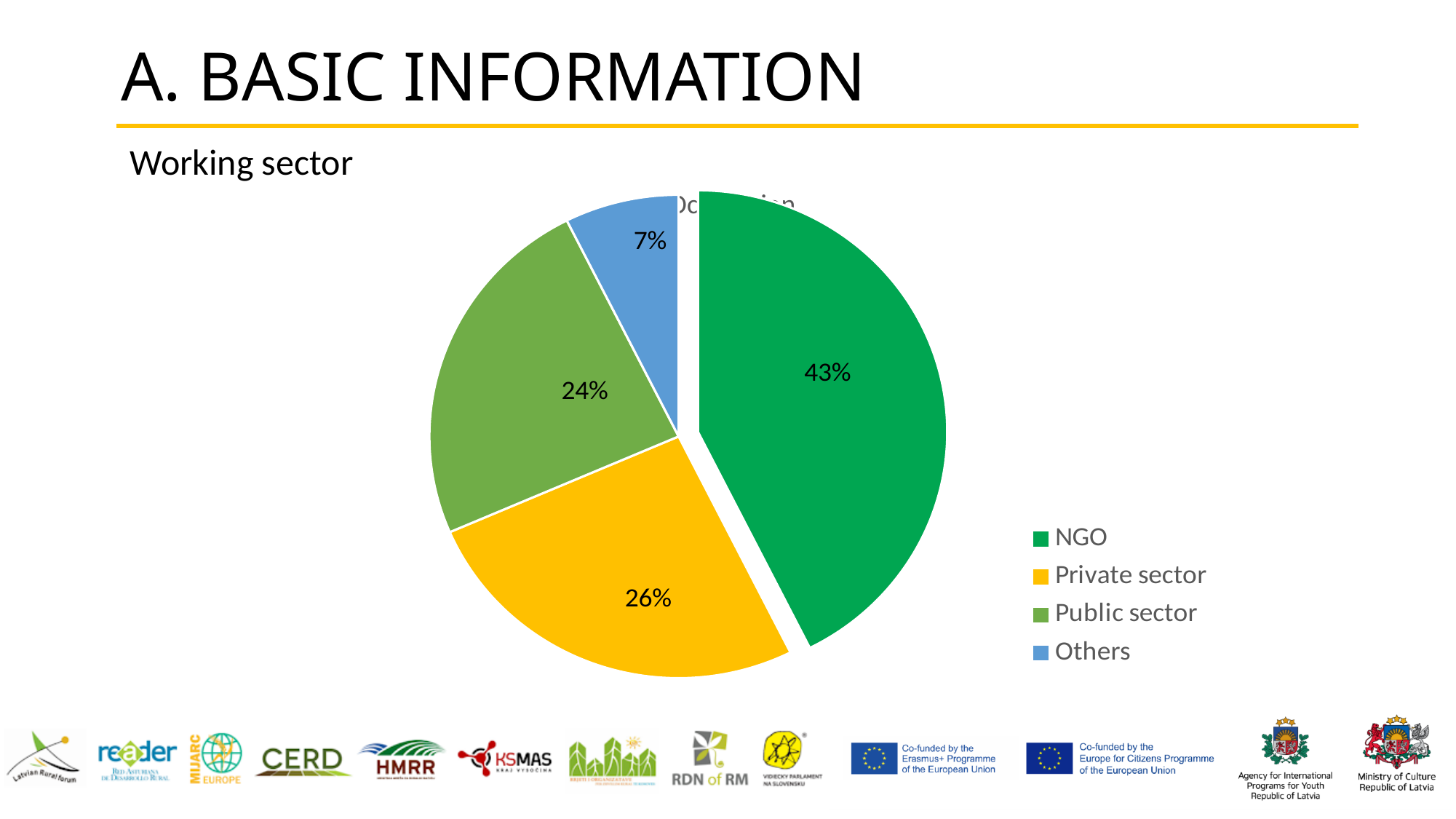
What type of chart is shown on the slide? Pie chart How many categories does the legend list? 4 Which category has the largest share of the pie? NGO What is the difference in percentage points between NGO and Private sector? 17 Which is larger, the share for Private sector or the share for Public sector? Private sector Which category has the smallest share of the pie? Others What share of the pie does NGO represent? 43% What colour is the slice for Others? Blue What share of the pie does Public sector represent? 24% What share of the pie does Others represent? 7% What is the combined share of Private sector and Public sector? 50% What share of the pie does Private sector represent? 26%